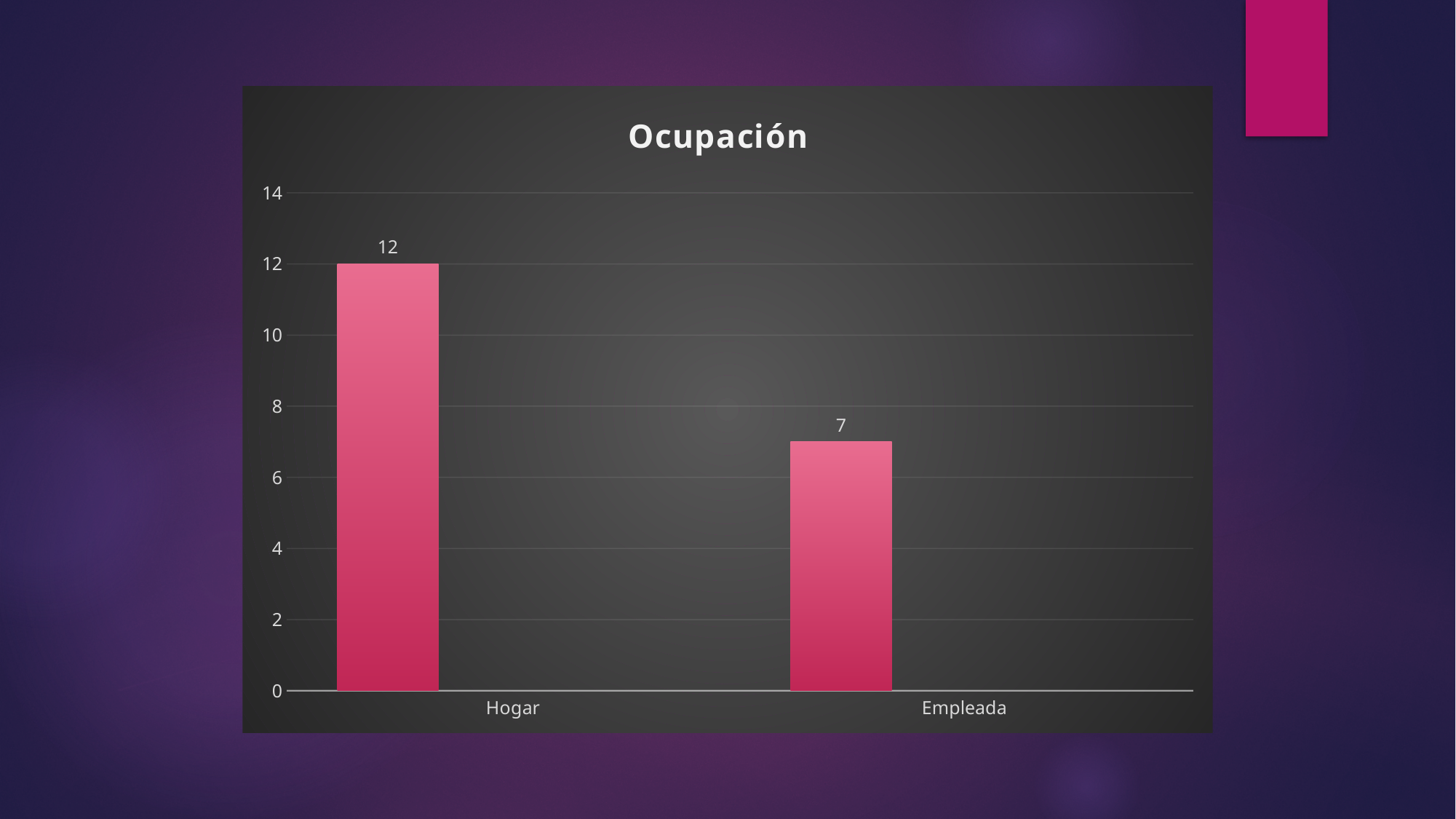
What is the highest value shown on the y axis? 14 Which category has the lowest value? Empleada What is the value for Empleada? 7 How many categories are shown on the x axis? 2 Which is larger, the value for Hogar or the value for Empleada? Hogar What is the difference between the values for Hogar and Empleada? 5 What is the title of the chart? Ocupación Which category has the highest value? Hogar Is the value for Hogar greater or less than 10? greater What is the value for Hogar? 12 What kind of chart is shown on the slide? bar chart Is the value for Empleada greater or less than 8? less